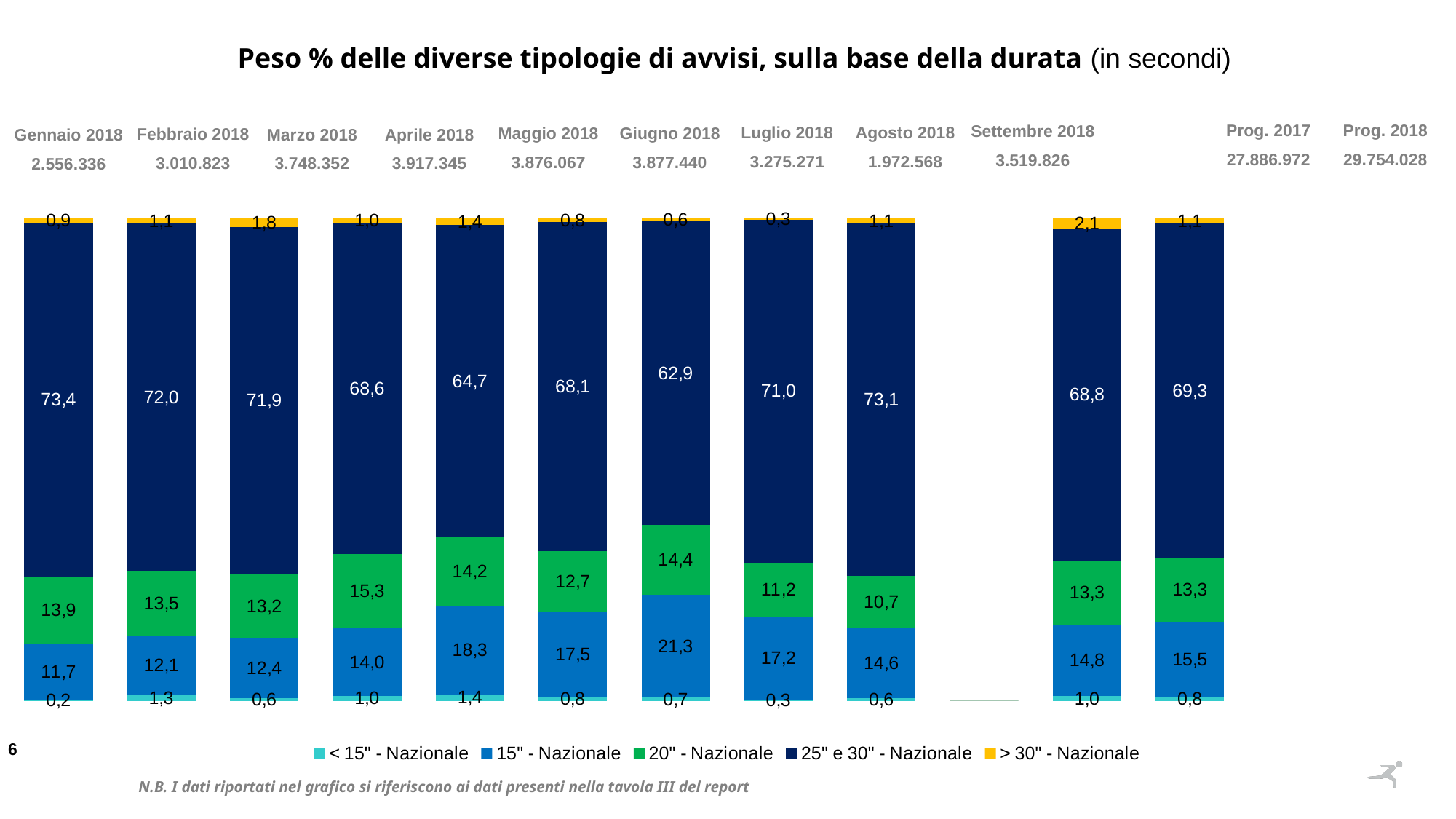
What is the highest value shown for the 25" e 30" - Nazionale series? 73,4 What is the value of the 15" - Nazionale segment for Prog. 2018? 15,5 What is the difference between the 25" e 30" - Nazionale values for Prog. 2018 and Prog. 2017? 0,5 How many series does the legend list? 5 What is the lowest value shown for the > 30" - Nazionale series? 0,3 What is the value of the 20" - Nazionale segment for Marzo 2018? 13,2 What is the value of the 25" e 30" - Nazionale segment for Gennaio 2018? 73,4 Which has the larger 15" - Nazionale value, Gennaio 2018 or Febbraio 2018? Febbraio 2018 What kind of chart is shown on the slide? Stacked bar chart What colour represents the > 30" - Nazionale series in the legend? Yellow What is the value of the < 15" - Nazionale segment for Febbraio 2018? 1,3 What is the value of the > 30" - Nazionale segment for Prog. 2017? 2,1